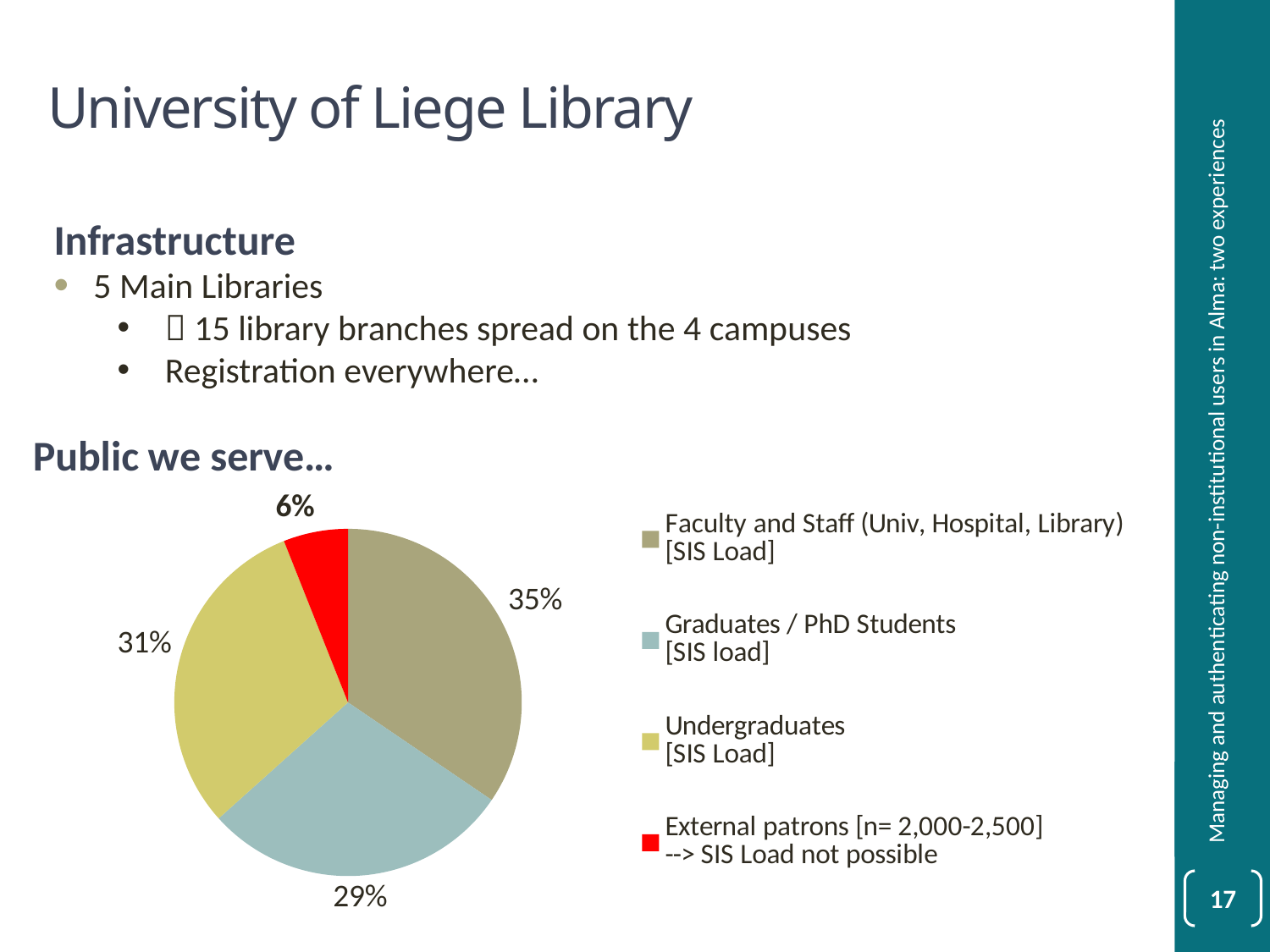
What share of the pie is Graduates / PhD Students [SIS load]? 29% What share of the pie is Undergraduates [SIS Load]? 31% What colour is the External patrons slice? red Which category has the smallest slice of the pie? External patrons What kind of chart is shown on the slide? pie chart Which slice is larger: Undergraduates or Graduates / PhD Students? Undergraduates What share of the pie is External patrons? 6% What share of the pie is Faculty and Staff (Univ, Hospital, Library) [SIS Load]? 35% How many slices does the pie chart have? 4 What is the difference in percentage points between the Faculty and Staff slice and the External patrons slice? 29 Which category has the largest slice of the pie? Faculty and Staff (Univ, Hospital, Library) [SIS Load] How many entries does the legend list? 4